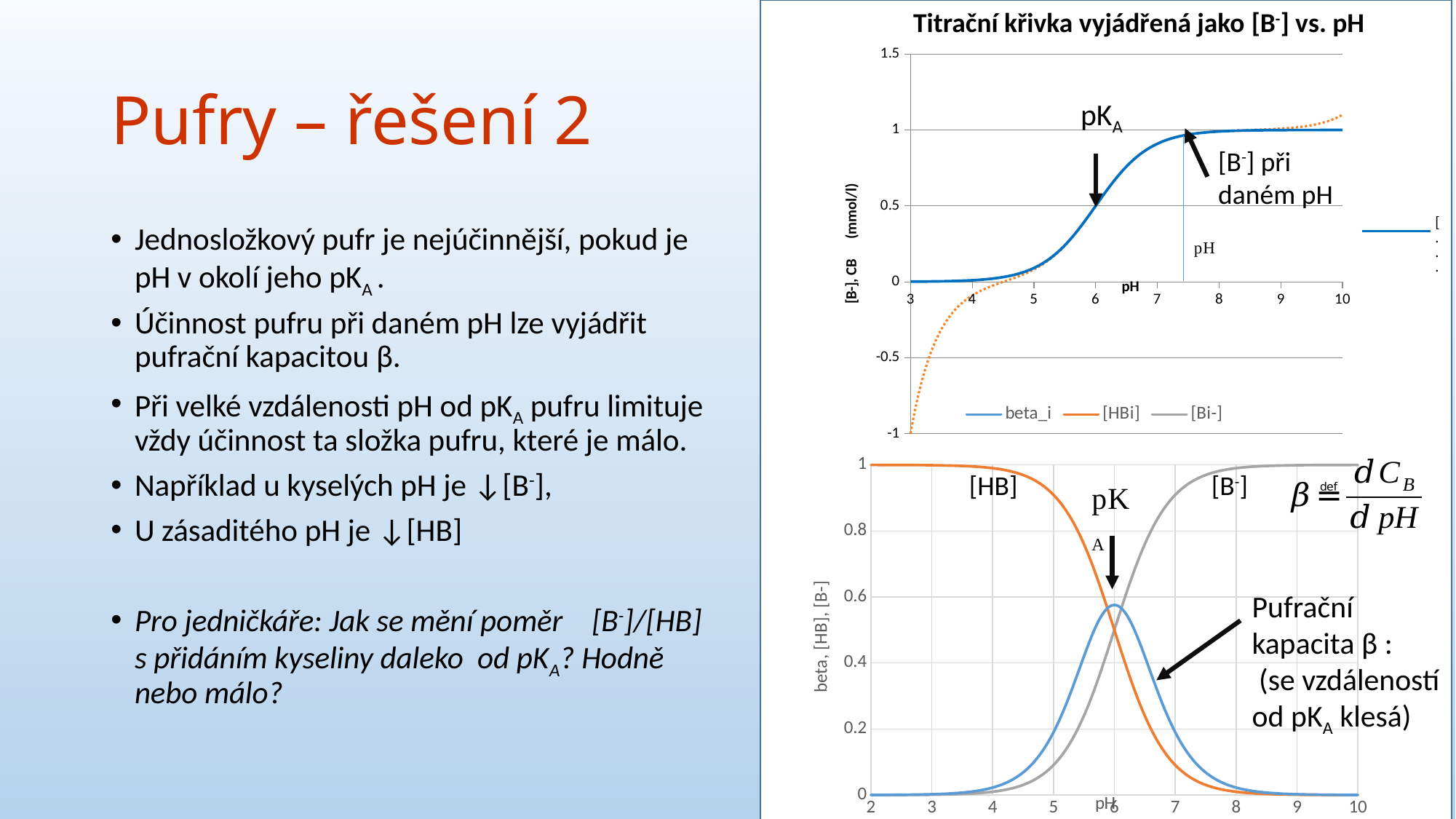
In the bottom chart, does the [Bi-] series rise or fall as pH increases? rise In the bottom chart, is the value of beta_i at pH 9 greater or less than 0.2? less In the bottom chart, is the value of [Bi-] at pH 9 greater or less than 0.8? greater In the top chart, is the value of the solid blue curve at pH 9 greater or less than 0.5? greater What is the title of the top chart on the slide? Titrační křivka vyjádřená jako [B-] vs. pH Which series are listed in the legend of the bottom chart? beta_i, [HBi], [Bi-] How many series does the legend of the bottom chart list? 3 In the bottom chart, does the [HBi] series rise or fall as pH increases? fall What kind of chart is the top chart titled "Titrační křivka vyjádřená jako [B-] vs. pH"? line chart